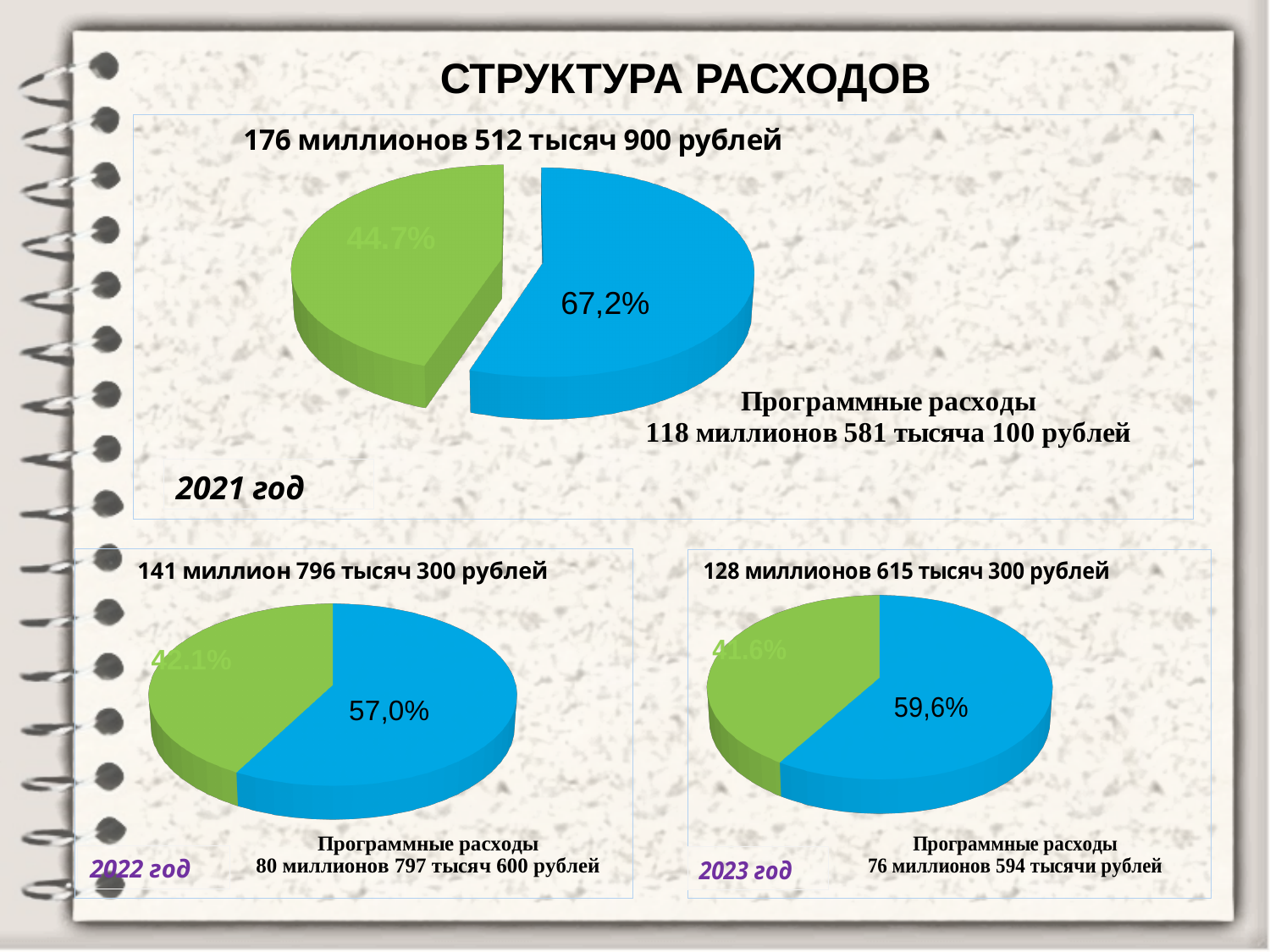
In the 2021 год pie chart, what percentage is printed on the blue slice? 67,2% In the 2023 год pie chart, which slice is larger, the blue one or the green one? the blue one What total amount is printed above the 2021 год pie chart? 176 миллионов 512 тысяч 900 рублей In the 2023 год pie chart, what percentage is printed on the blue slice? 59,6% In the 2021 год pie chart, which slice is larger, the blue one or the green one? the blue one What amount of Программные расходы is printed for the 2023 год pie chart? 76 миллионов 594 тысячи рублей Which year's pie chart shows the smallest blue-slice percentage: 2021, 2022 or 2023? 2022 Which year's pie chart shows the largest blue-slice percentage: 2021, 2022 or 2023? 2021 What kind of chart is used for the 2021 год chart? pie chart In the 2022 год pie chart, what percentage is printed on the blue slice? 57,0% How many slices does the 2022 год pie chart have? 2 How many pie charts are shown on the slide? 3